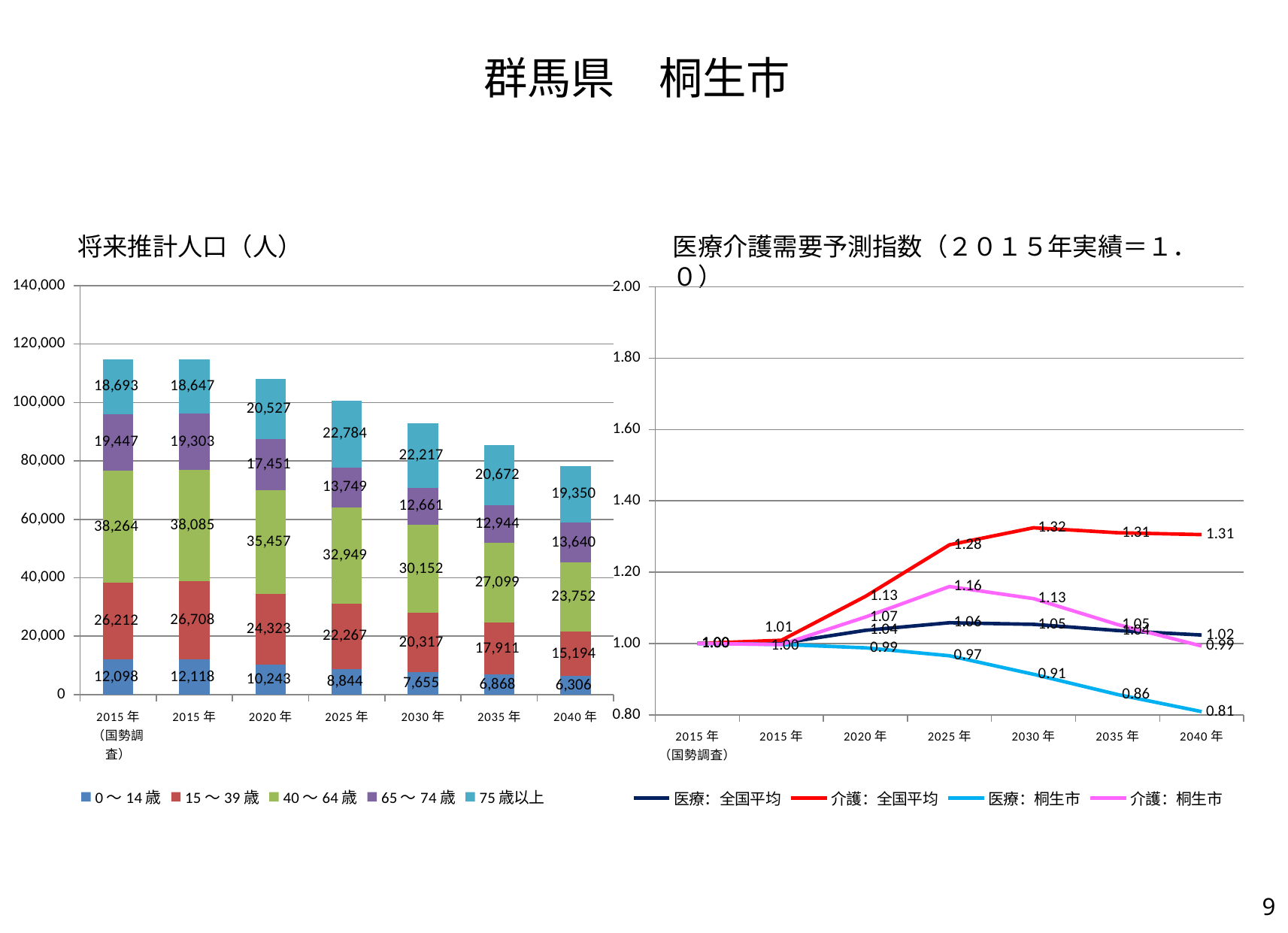
What kind of chart is the 医療介護需要予測指数 chart on the right? line chart In the 将来推計人口（人） chart, how many series does the legend list? 5 In the 医療介護需要予測指数 chart, what is the value for 医療：桐生市 in 2040年? 0.81 In the 将来推計人口（人） chart, what is the total of the stacked bar for 2040年? 78,242 In the 医療介護需要予測指数 chart, what is the value for 介護：全国平均 in 2030年? 1.32 In the 将来推計人口（人） chart, what is the difference between the 40～64歳 values for 2015年 and 2040年? 14,333 In the 医療介護需要予測指数 chart, which is larger in 2025年: 介護：全国平均 or 介護：桐生市? 介護：全国平均 In the 将来推計人口（人） chart, what is the value for 0～14歳 in 2040年? 6,306 In the 将来推計人口（人） chart, what is the value for 75歳以上 in 2020年? 20,527 In the 将来推計人口（人） chart, which year has the lowest value for 15～39歳? 2040年 In the 将来推計人口（人） chart, which year has the highest value for 75歳以上? 2025年 In the 将来推計人口（人） chart, how many bars are plotted? 7